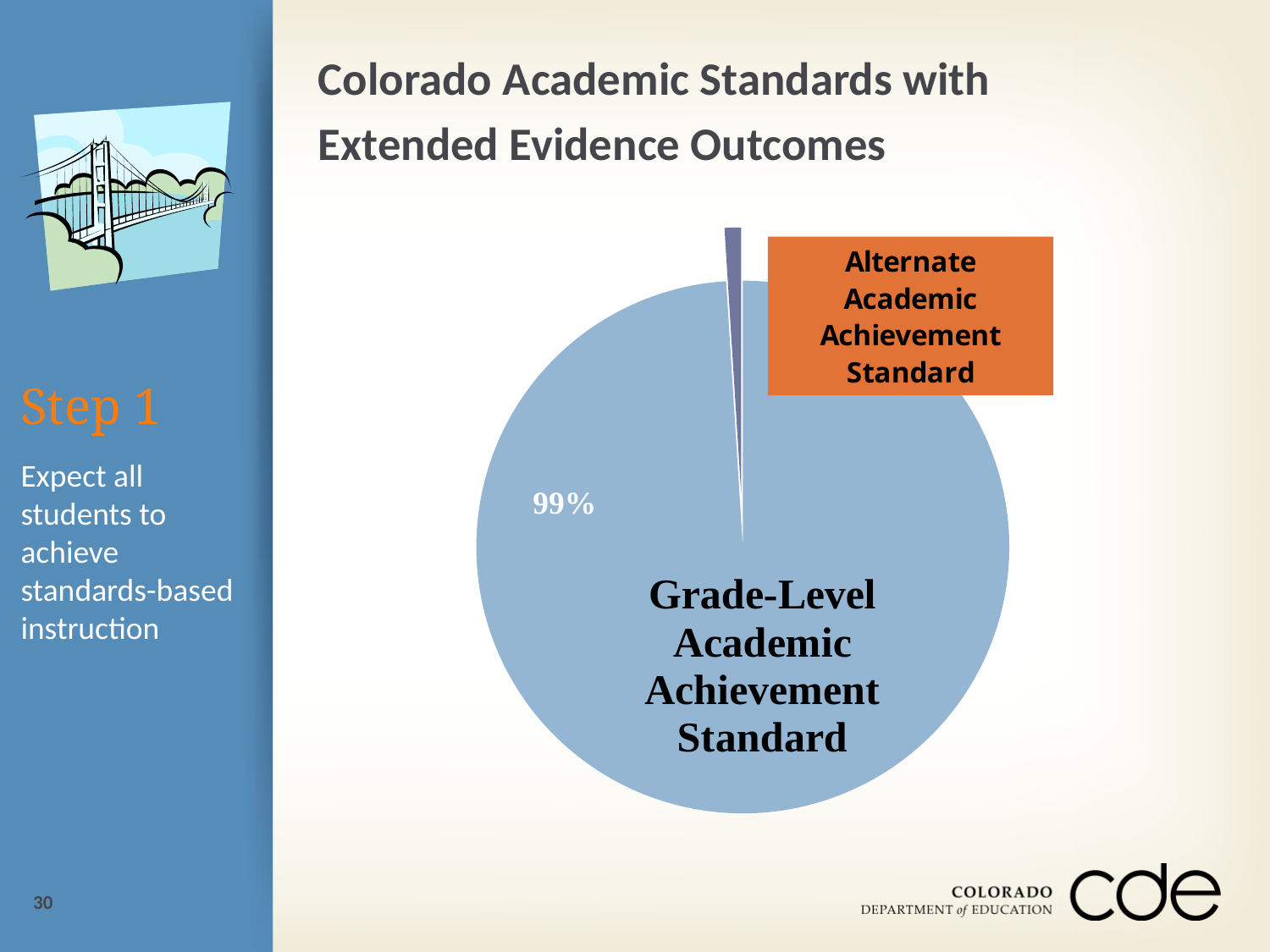
What share of the pie does the Grade-Level Academic Achievement Standard slice represent? 99% Which slice of the pie chart is the largest? Grade-Level Academic Achievement Standard What colour is the box labelling the Alternate Academic Achievement Standard slice? orange How many slices does the pie chart have? 2 What kind of chart is shown on the slide? pie chart What value is printed on the Grade-Level Academic Achievement Standard slice? 99% Which is larger: the Grade-Level Academic Achievement Standard slice or the Alternate Academic Achievement Standard slice? Grade-Level Academic Achievement Standard Which slice of the pie chart is the smallest? Alternate Academic Achievement Standard What is the title of the chart on the slide? Colorado Academic Standards with Extended Evidence Outcomes